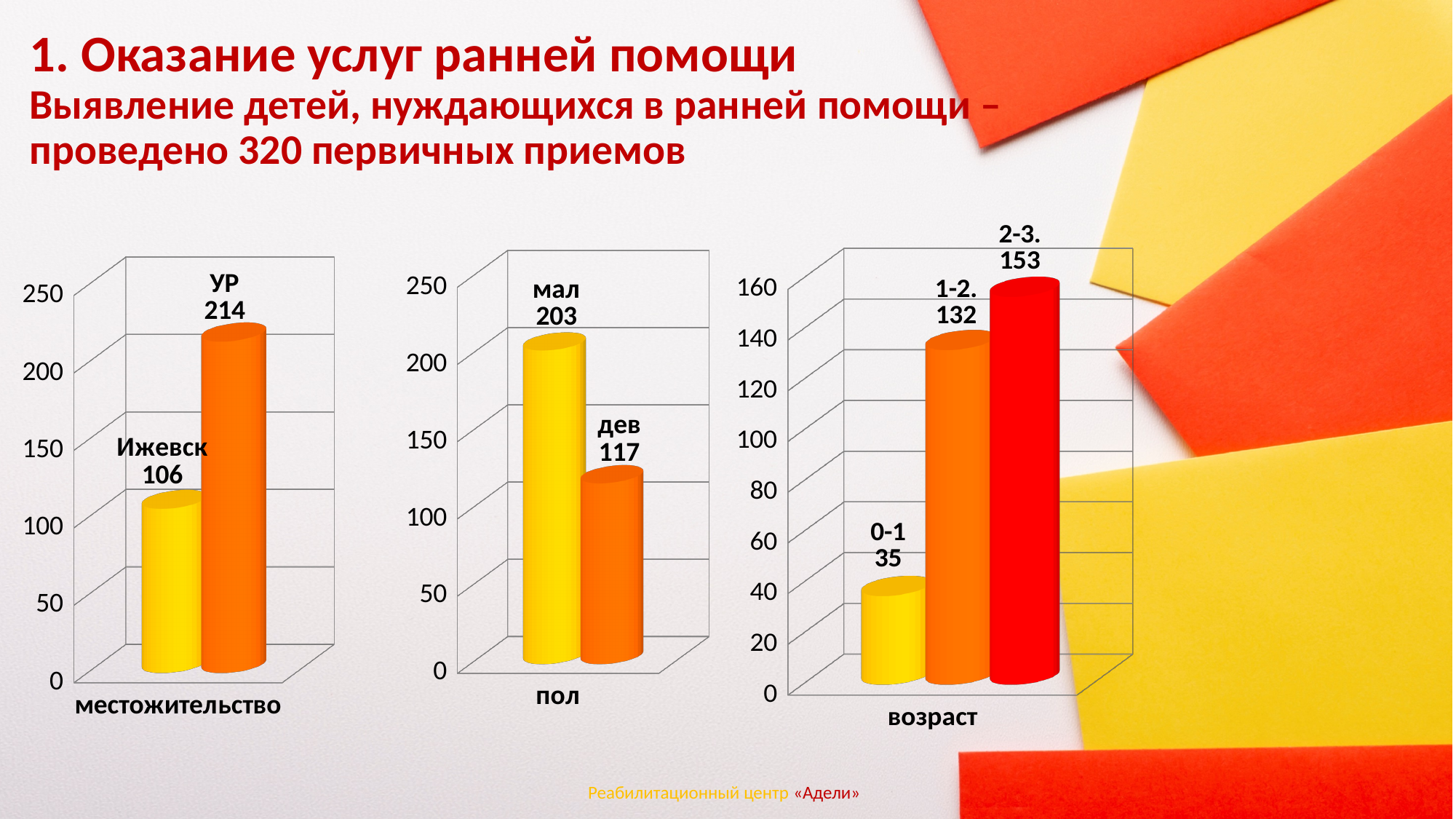
In the 'пол' chart, which category is larger, мал or дев? мал In the 'возраст' chart, what is the value for 0-1? 35 In the 'возраст' chart, which category has the highest value? 2-3. How many bars are in the 'возраст' chart? 3 In the 'местожительство' chart, what is the difference between УР and Ижевск? 108 In the 'пол' chart, what is the value for мал? 203 In the 'возраст' chart, which category has the lowest value? 0-1 In the 'пол' chart, what is the value for дев? 117 In the 'пол' chart, what is the difference between мал and дев? 86 In the 'местожительство' chart, what is the value for УР? 214 In the 'местожительство' chart, what is the value for Ижевск? 106 What type of chart is the 'пол' chart? bar chart